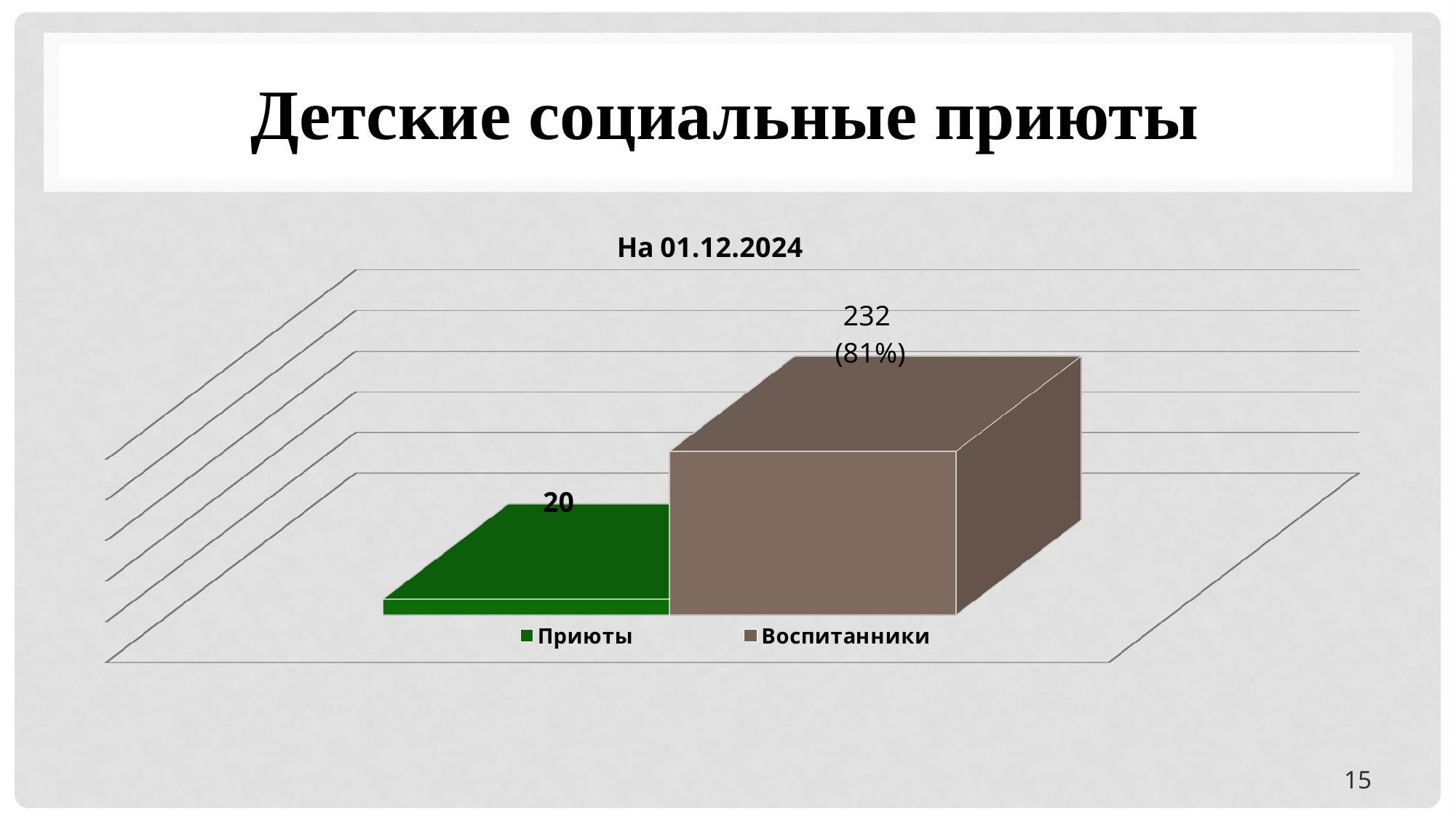
Which series has the higher value, Приюты or Воспитанники? Воспитанники Which series has the lowest value? Приюты What percentage is shown next to the value for Воспитанники? 81% What is the title of the chart? На 01.12.2024 What colour is the bar for Приюты? green What is the value for Воспитанники? 232 (81%) How many series does the legend list? 2 What is the value for Приюты? 20 What kind of chart is shown on the slide? bar chart What is the difference between the values for Воспитанники and Приюты? 212